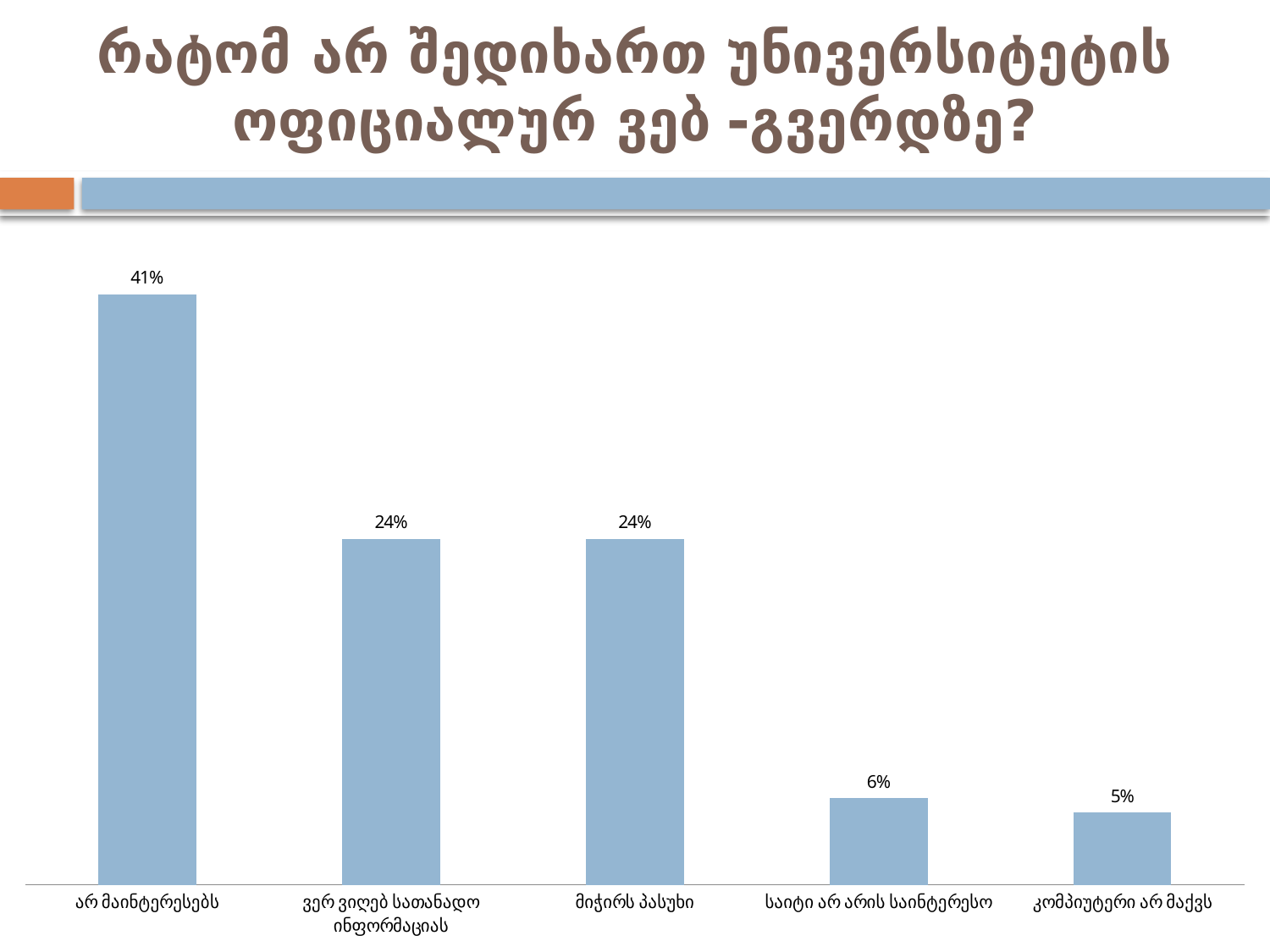
What is the difference between the values for "არ მაინტერესებს" and "მიჭირს პასუხი"? 17% What is the difference between the values for "საიტი არ არის საინტერესო" and "კომპიუტერი არ მაქვს"? 1% What value is shown for the bar labelled "მიჭირს პასუხი"? 24% What kind of chart is shown on the slide? Bar chart What value is shown for the bar labelled "საიტი არ არის საინტერესო"? 6% Which category has the lowest value? კომპიუტერი არ მაქვს What value is shown for the bar labelled "არ მაინტერესებს"? 41% What value is shown for the bar labelled "კომპიუტერი არ მაქვს"? 5% What colour are the bars in the chart? Light blue How many categories are shown on the chart? 5 Which is larger: the value for "ვერ ვიღებ სათანადო ინფორმაციას" or the value for "საიტი არ არის საინტერესო"? ვერ ვიღებ სათანადო ინფორმაციას Which category has the highest value? არ მაინტერესებს